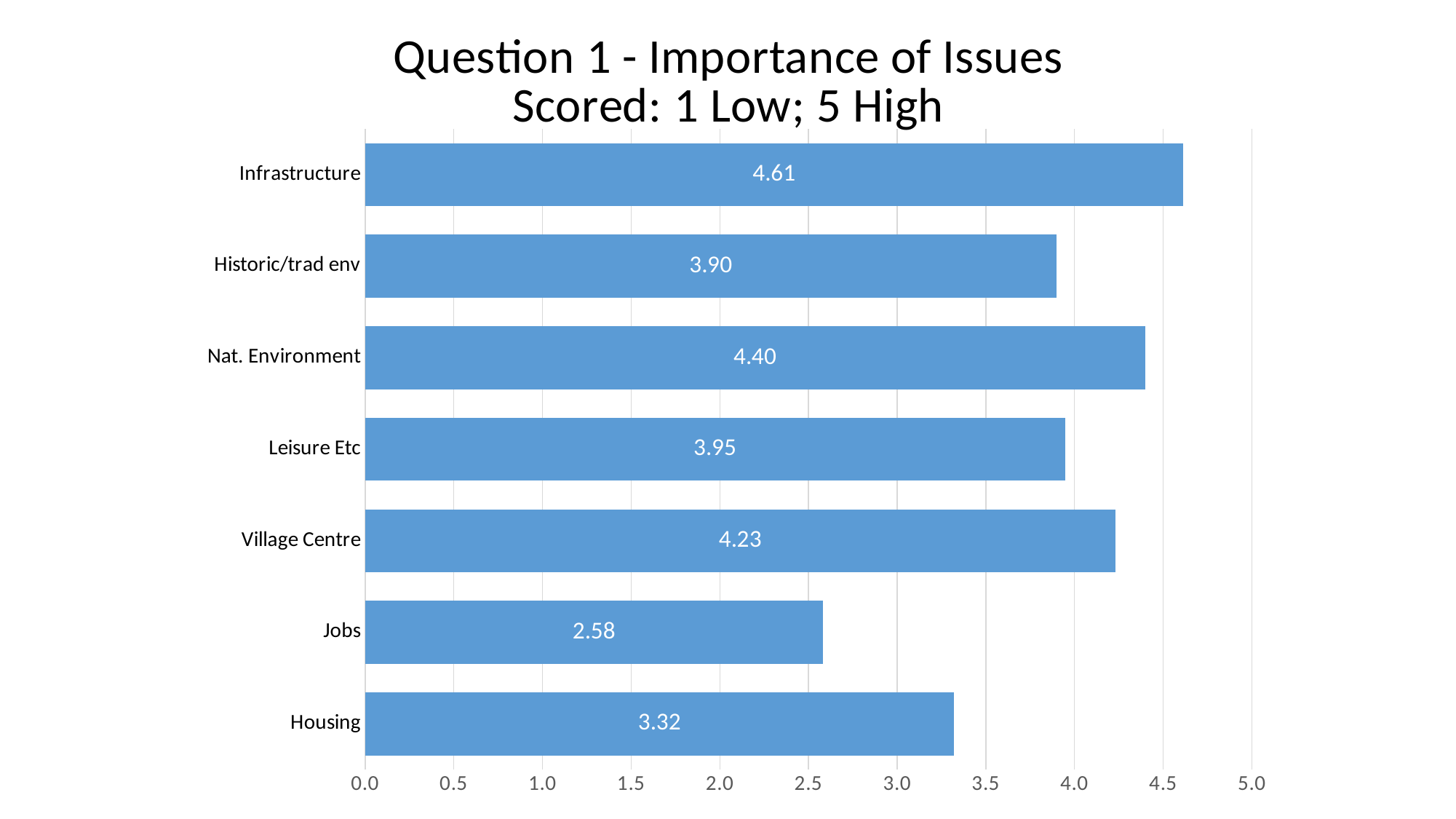
What is the title of the chart? Question 1 - Importance of Issues Scored: 1 Low; 5 High Is the score for Housing greater or less than 3.5? less What kind of chart is shown on the slide? bar chart Which has a higher score, Nat. Environment or Historic/trad env? Nat. Environment Which issue has the highest score? Infrastructure How many issues are shown in the chart? 7 What is the difference between the scores for Infrastructure and Housing? 1.29 What is the difference between the scores for Leisure Etc and Jobs? 1.37 Which issue has the lowest score? Jobs What is the score for Jobs? 2.58 What is the score for Infrastructure? 4.61 What is the score for Village Centre? 4.23